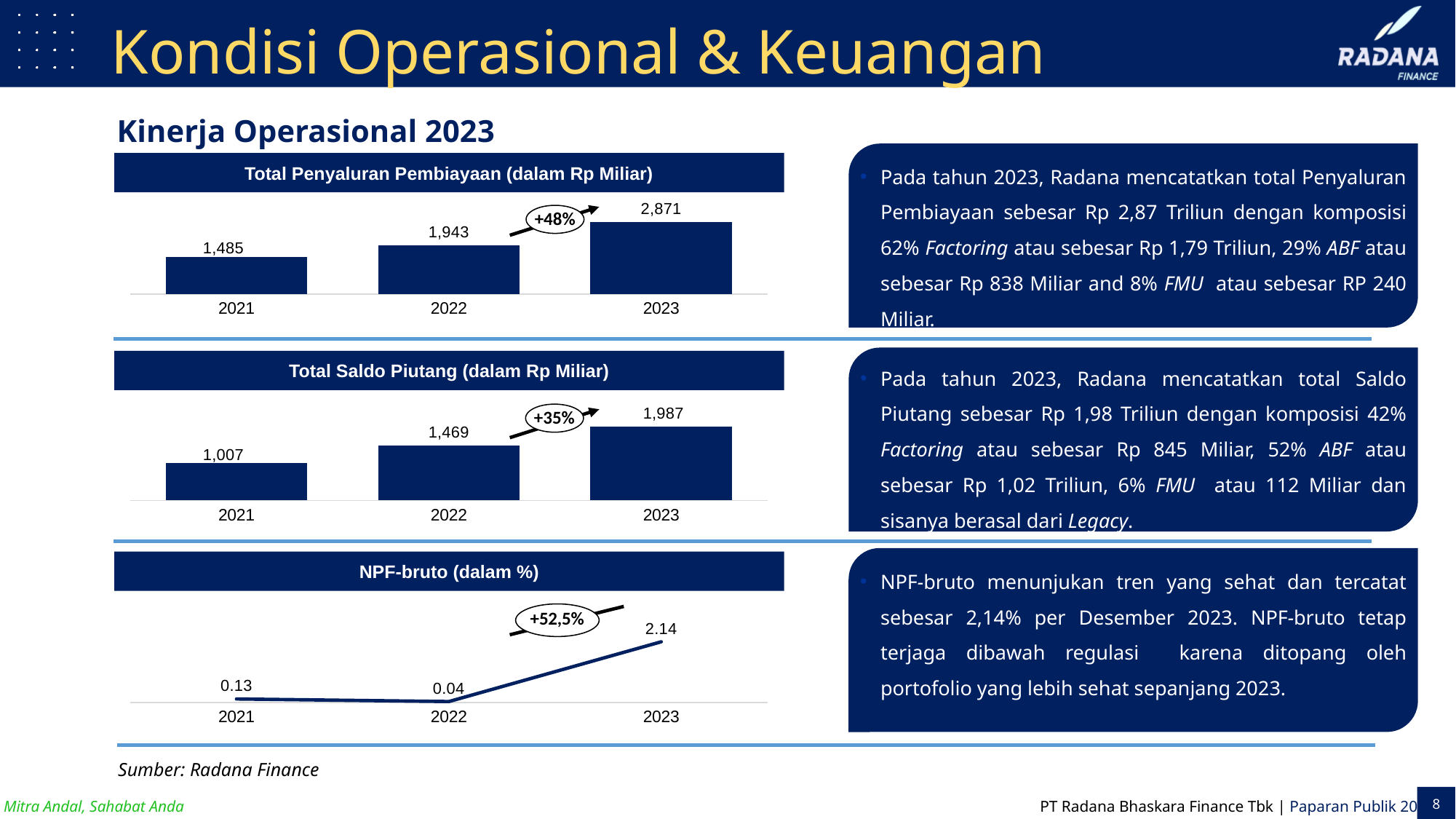
In the 'Total Penyaluran Pembiayaan (dalam Rp Miliar)' chart, which year has the lowest value? 2021 What kind of chart is the 'Total Penyaluran Pembiayaan (dalam Rp Miliar)' chart? Bar chart How many years are shown on the x axis of the 'NPF-bruto (dalam %)' chart? 3 In the 'NPF-bruto (dalam %)' chart, what is the value for 2022? 0.04 In the 'Total Saldo Piutang (dalam Rp Miliar)' chart, what is the value for 2021? 1,007 In the 'Total Saldo Piutang (dalam Rp Miliar)' chart, which year has the highest value? 2023 In the 'NPF-bruto (dalam %)' chart, which year has the highest value? 2023 In the 'Total Penyaluran Pembiayaan (dalam Rp Miliar)' chart, what is the value for 2023? 2,871 In the 'Total Saldo Piutang (dalam Rp Miliar)' chart, what is the difference between the 2022 and 2021 values? 462 In the 'Total Penyaluran Pembiayaan (dalam Rp Miliar)' chart, what is the difference between the 2023 and 2022 values? 928 In the 'Total Saldo Piutang (dalam Rp Miliar)' chart, do the values rise or fall from 2021 to 2023? Rise What kind of chart is the 'NPF-bruto (dalam %)' chart? Line chart